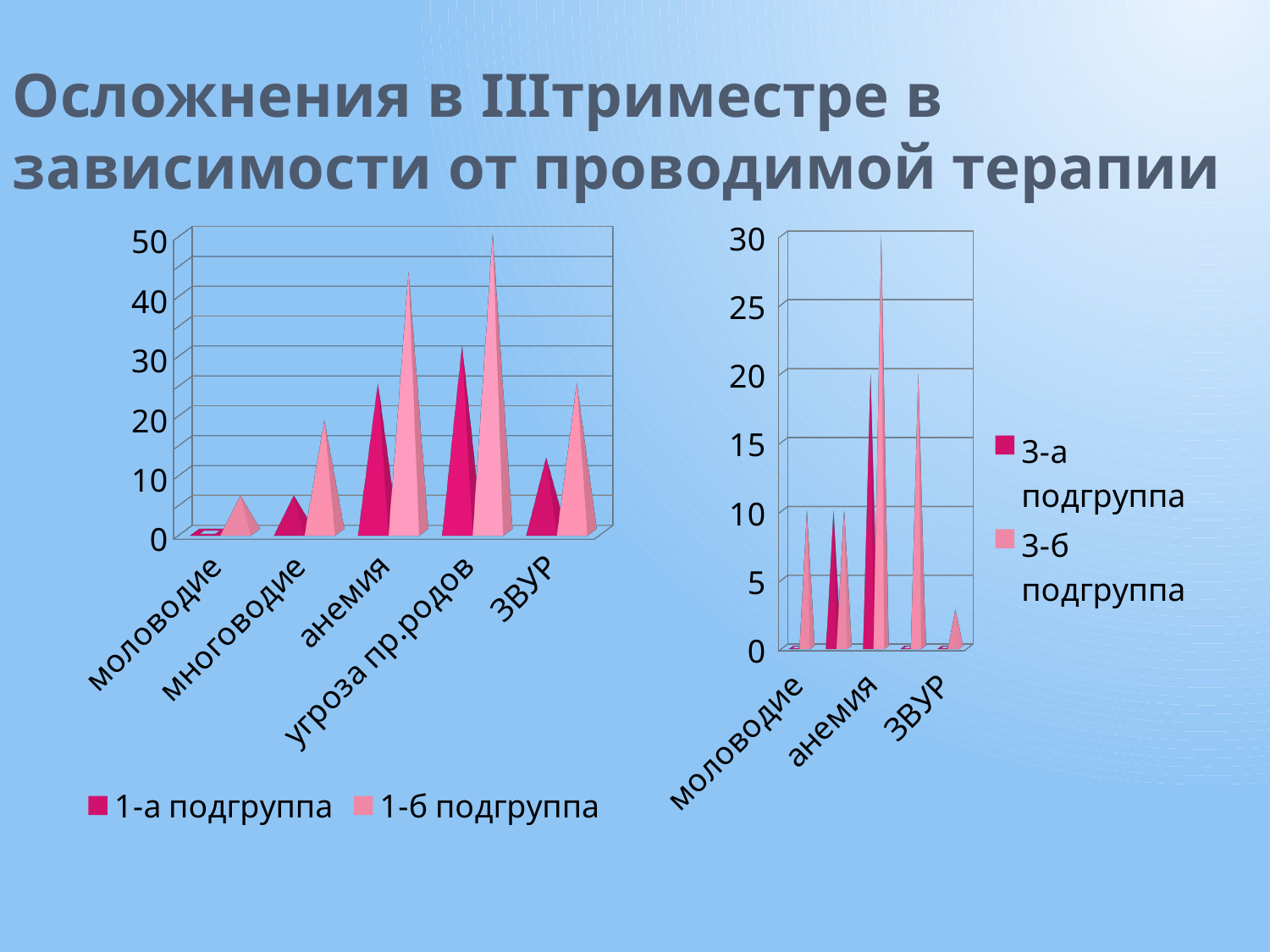
In the left chart, is the value for 1-а подгруппа at угроза пр.родов greater or less than 20? greater In the right chart, is the value for 3-б подгруппа at анемия greater or less than 25? greater How many series does the legend of the right chart list? 2 How many categories are shown on the x axis of the left chart? 5 In the left chart, which series has the larger value at анемия, 1-а подгруппа or 1-б подгруппа? 1-б подгруппа What kind of chart is the left chart on the slide? bar chart In the left chart, which category has the highest value for 1-б подгруппа? угроза пр.родов In the right chart, is the value for 3-б подгруппа at ЗВУР greater or less than 5? less In the left chart, which category has the lowest value for 1-б подгруппа? моловодие What are the two legend entries of the right chart? 3-а подгруппа and 3-б подгруппа How many series does the legend of the left chart list? 2